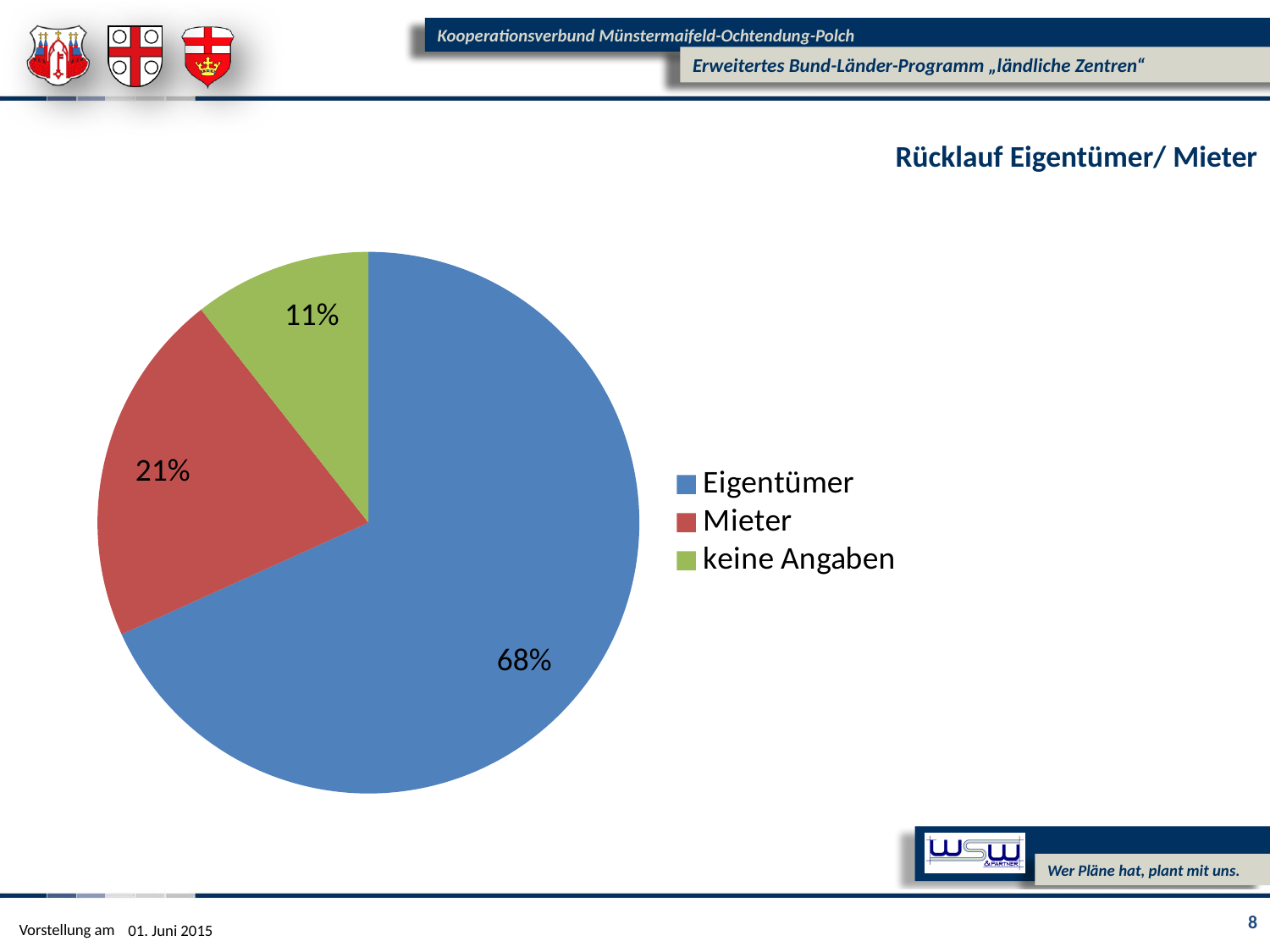
How many categories does the pie chart show? 3 What is the difference in percentage points between Eigentümer and Mieter? 47 Which colour represents Mieter in the pie chart? red Which category has the largest slice of the pie? Eigentümer What share of the pie does keine Angaben have? 11% Which is larger, the share for Mieter or the share for keine Angaben? Mieter What is the difference in percentage points between Mieter and keine Angaben? 10 What is the title of the chart? Rücklauf Eigentümer/ Mieter What kind of chart is shown on the slide? pie chart What share of the pie does Mieter have? 21% What share of the pie does Eigentümer have? 68% Which category has the smallest slice of the pie? keine Angaben